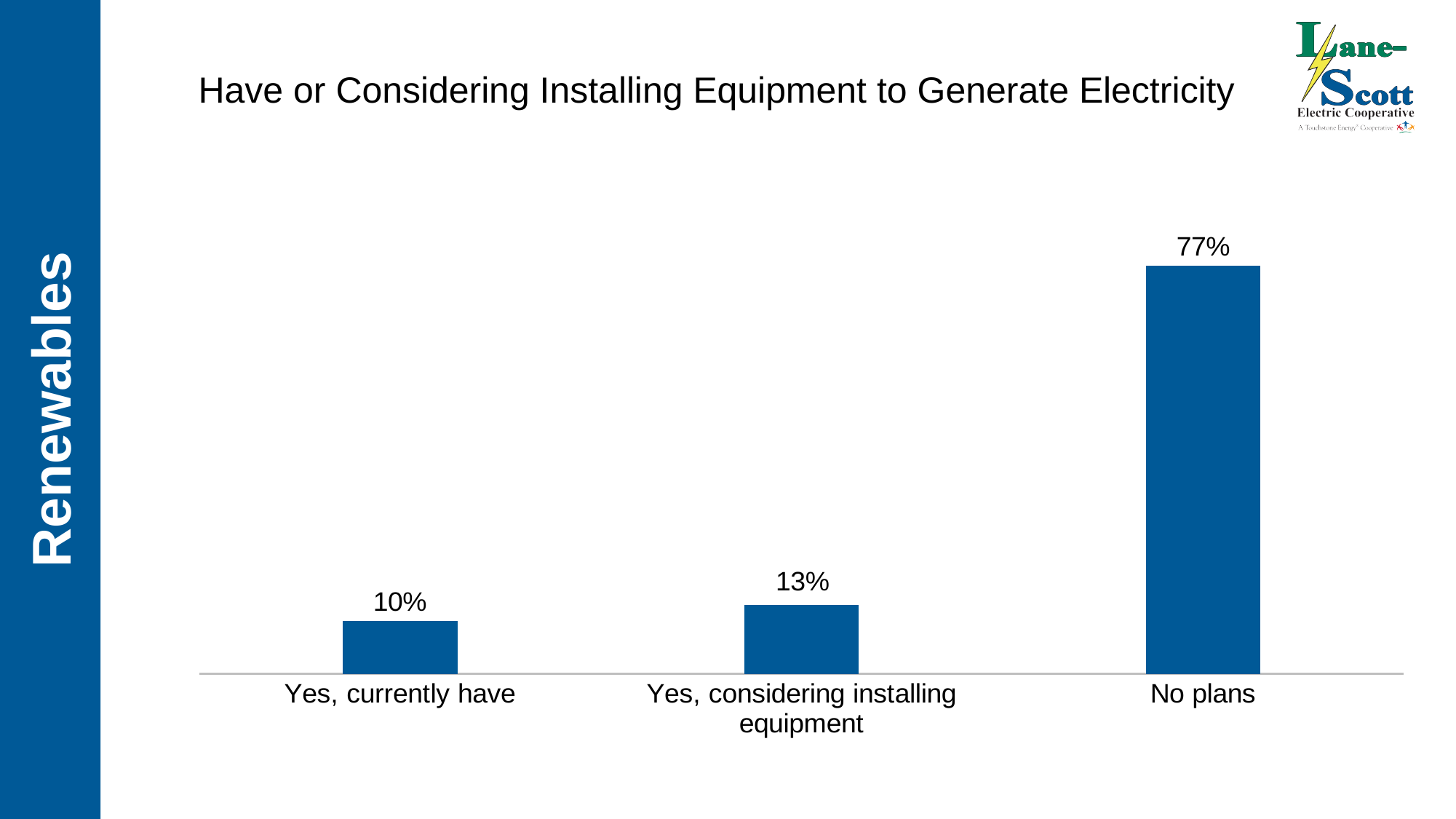
Which is larger: the value for "Yes, considering installing equipment" or the value for "Yes, currently have"? Yes, considering installing equipment What is the total of the three percentages shown in the chart? 100% Which category has the lowest value? Yes, currently have What is the difference between the "No plans" value and the "Yes, currently have" value? 67% What kind of chart is shown on the slide? Bar chart How many categories are shown in the chart? 3 What is the title of the chart? Have or Considering Installing Equipment to Generate Electricity What is the difference between "Yes, considering installing equipment" and "Yes, currently have"? 3% What percentage of respondents said "No plans"? 77% What percentage of respondents said "Yes, currently have"? 10% What percentage of respondents said "Yes, considering installing equipment"? 13% Which category has the highest value? No plans